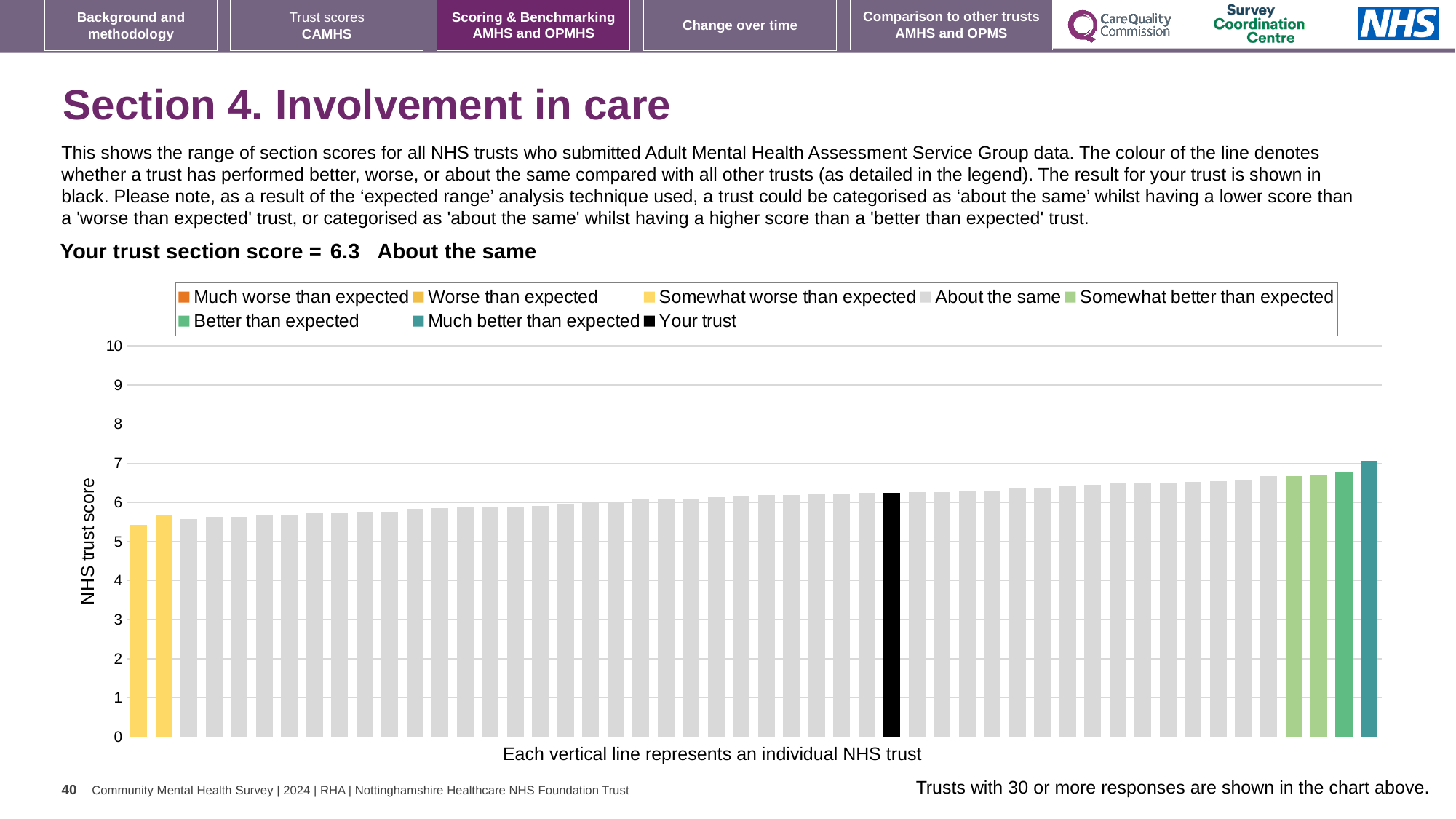
What colour is used for the bar representing your trust? black What is the label on the y axis of the chart? NHS trust score Is the value of the lowest bar greater or less than 5? greater Which legend category does the highest bar belong to? Much better than expected What kind of chart is shown on the slide? bar chart Do the bar values rise or fall from left to right along the x axis? rise Is the value of the lowest bar greater or less than 6? less How many entries does the chart legend list? 8 How many bars are coloured yellow? 2 Which category is your trust placed in for this section? About the same Is the value of the black bar (your trust) greater or less than 6? greater What is the section score for your trust? 6.3